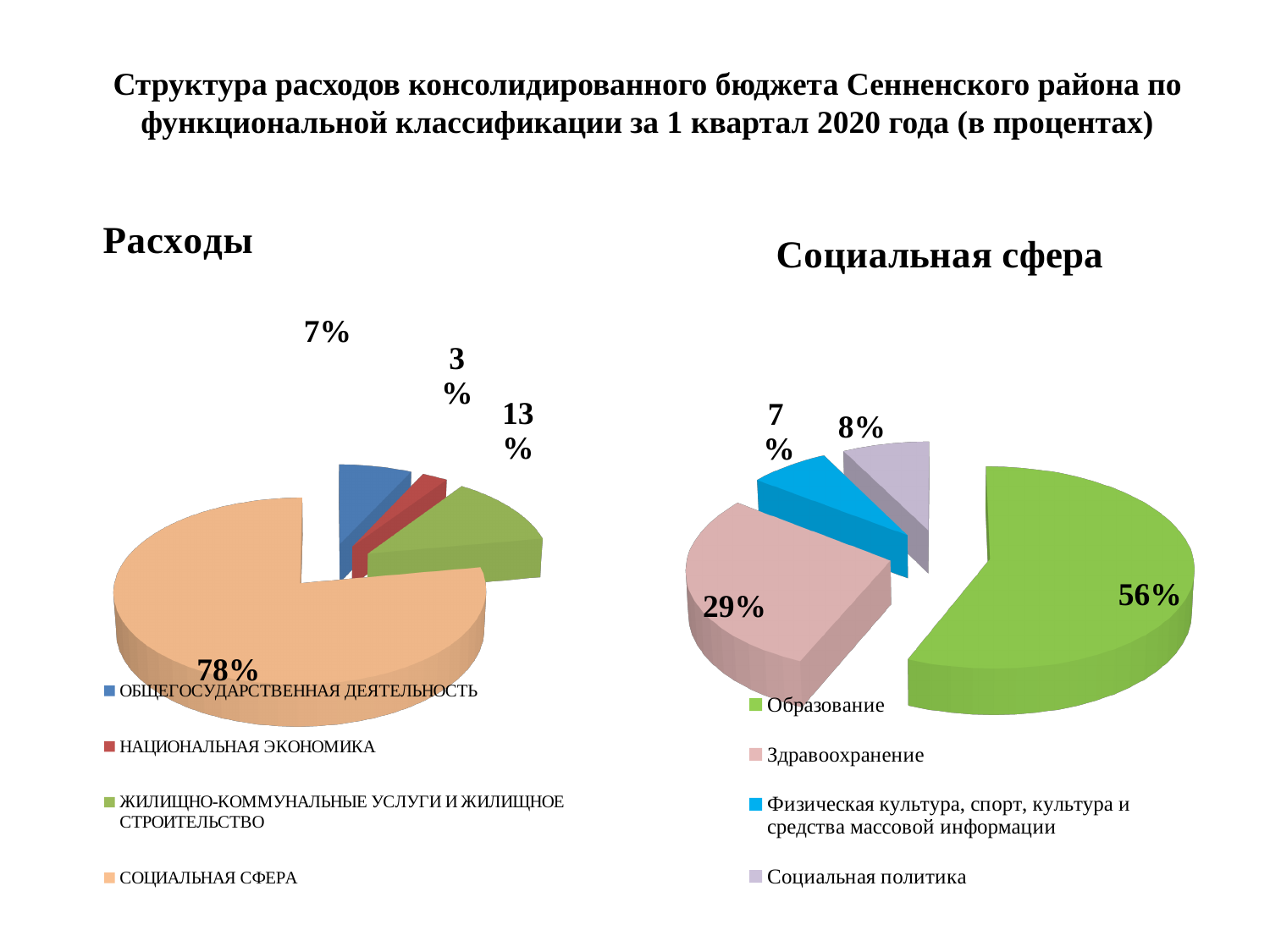
What type of chart is the "Социальная сфера" chart? Pie chart In the "Социальная сфера" chart, what share is Образование? 56% In the "Расходы" chart, what share is СОЦИАЛЬНАЯ СФЕРА? 78% In the "Социальная сфера" chart, what share is Здравоохранение? 29% In the "Социальная сфера" chart, what is the difference in percentage points between Образование and Здравоохранение? 27 In the "Расходы" chart, which category has the smallest share? НАЦИОНАЛЬНАЯ ЭКОНОМИКА In the "Расходы" chart, how many categories are shown? 4 In the "Социальная сфера" chart, which is larger, Здравоохранение or Социальная политика? Здравоохранение In the "Расходы" chart, which category has the largest share? СОЦИАЛЬНАЯ СФЕРА